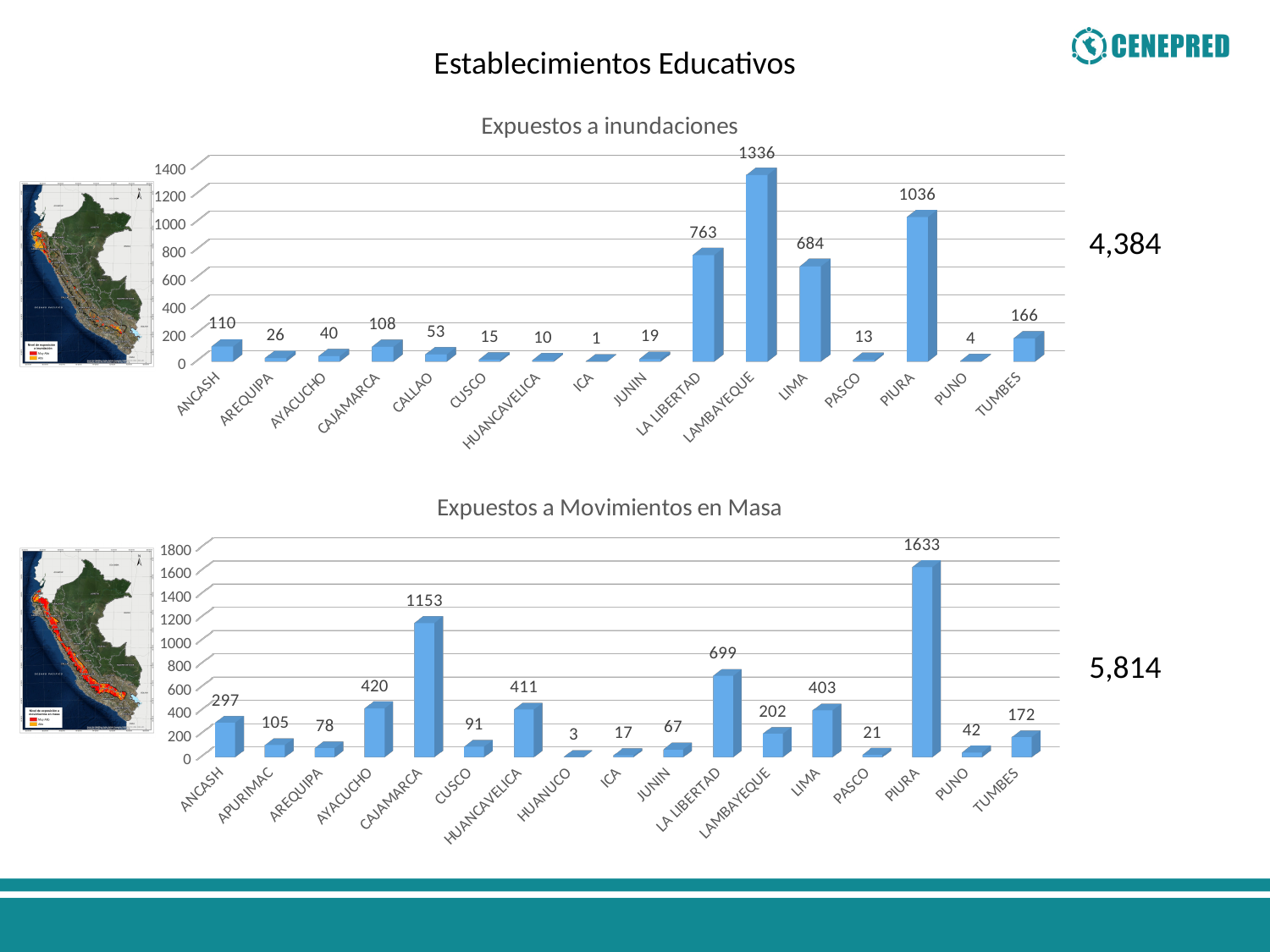
In the 'Expuestos a Movimientos en Masa' chart, what is the difference between AYACUCHO and HUANCAVELICA? 9 In the 'Expuestos a Movimientos en Masa' chart, what is the value for CAJAMARCA? 1153 What kind of chart is the 'Expuestos a Movimientos en Masa' chart? Bar chart In the 'Expuestos a inundaciones' chart, how many categories are shown on the x axis? 16 In the 'Expuestos a Movimientos en Masa' chart, which category has the highest value? PIURA In the 'Expuestos a inundaciones' chart, what is the difference between PIURA and LIMA? 352 In the 'Expuestos a inundaciones' chart, which category has the lowest value? ICA In the 'Expuestos a Movimientos en Masa' chart, how many categories are shown on the x axis? 17 What total is printed to the right of the 'Expuestos a inundaciones' chart? 4,384 In the 'Expuestos a Movimientos en Masa' chart, which category has the lowest value? HUANUCO In the 'Expuestos a inundaciones' chart, what is the value for LAMBAYEQUE? 1336 In the 'Expuestos a inundaciones' chart, which is larger, ANCASH or CAJAMARCA? ANCASH